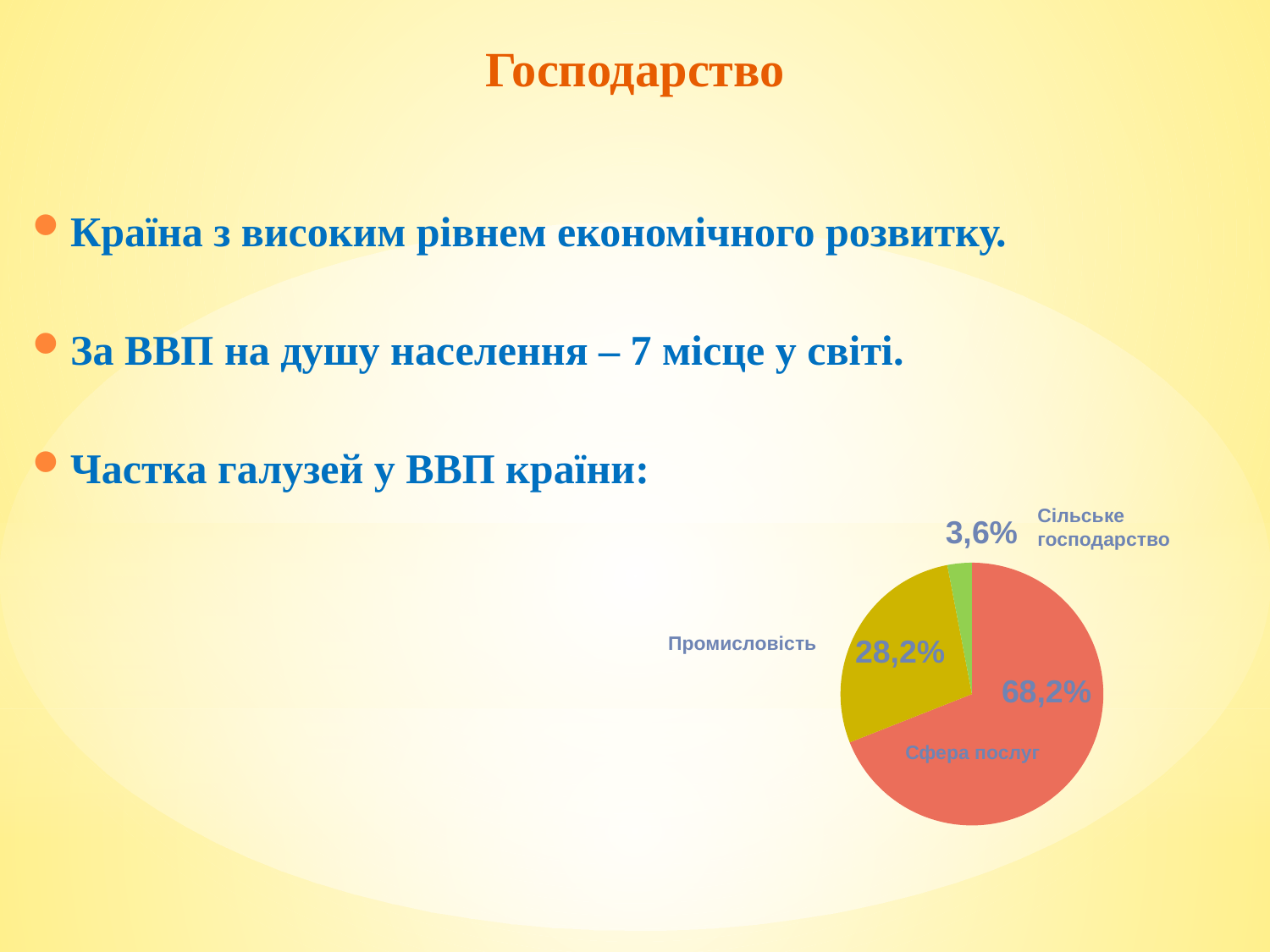
Which sector has the smallest share of GDP in the pie chart? Сільське господарство What share of GDP does Сфера послуг account for? 68,2% What colour is the slice for Сфера послуг? red What share of GDP does Промисловість account for? 28,2% What is the difference in percentage points between Промисловість and Сільське господарство? 24,6 percentage points What kind of chart is shown on the slide? pie chart Which sector has the largest share of GDP in the pie chart? Сфера послуг Which is larger, the share for Промисловість or the share for Сільське господарство? Промисловість What share of GDP does Сільське господарство account for? 3,6% What is the difference in percentage points between Сфера послуг and Промисловість? 40 percentage points How many slices does the pie chart have? 3 What colour is the slice for Промисловість? yellow